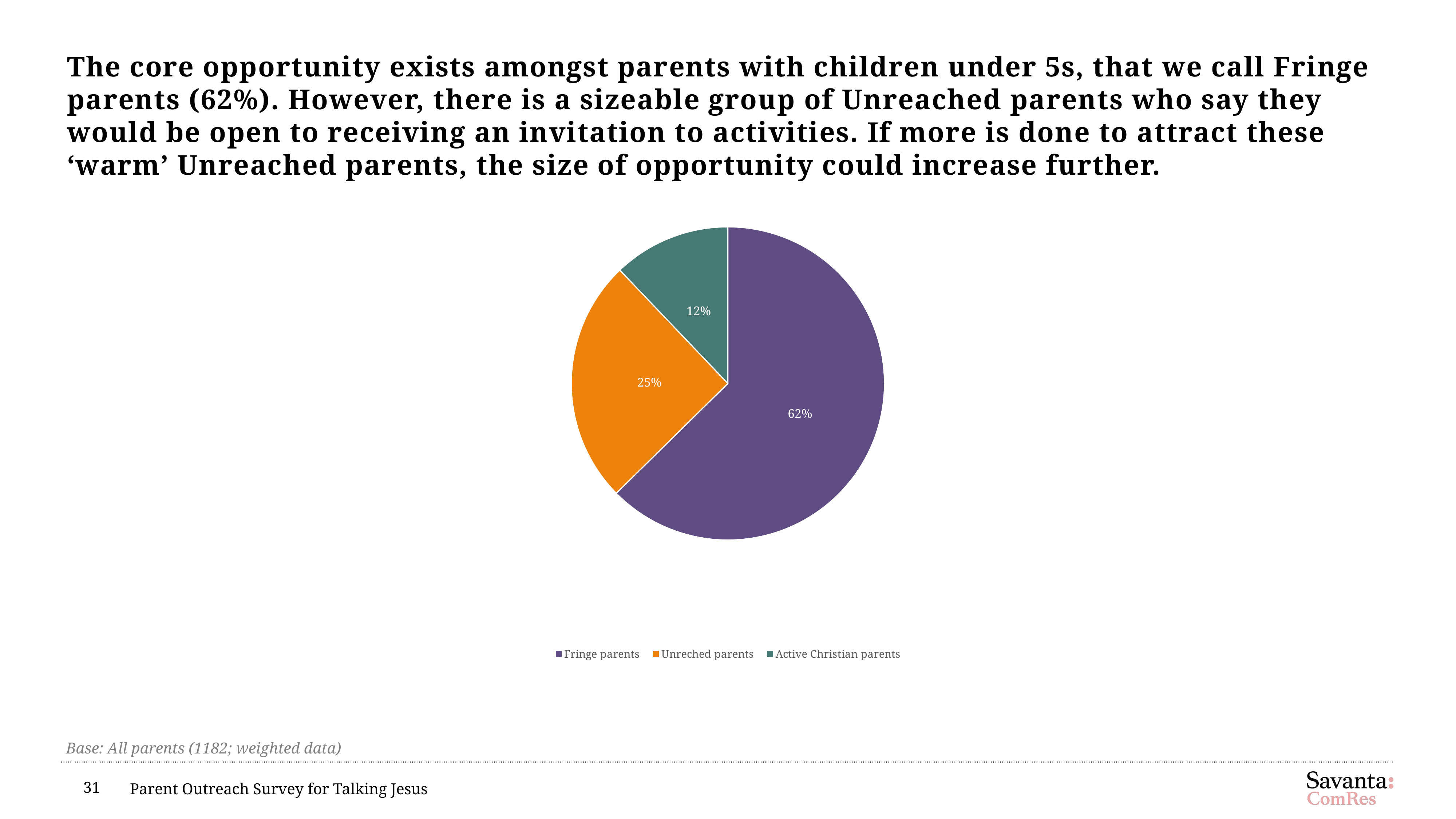
Which category has the largest slice of the pie? Fringe parents What share of the pie is Fringe parents? 62% What is the difference in percentage points between Unreched parents and Active Christian parents? 13 Which category has the smallest slice of the pie? Active Christian parents What share of the pie is Active Christian parents? 12% Which is larger, the slice for Unreched parents or the slice for Active Christian parents? Unreched parents What share of the pie is Unreched parents? 25% How many slices does the pie chart have? 3 What is the difference in percentage points between Fringe parents and Unreched parents? 37 What kind of chart is shown on the slide? pie chart What colour is the slice for Unreched parents? orange How many entries does the legend list? 3